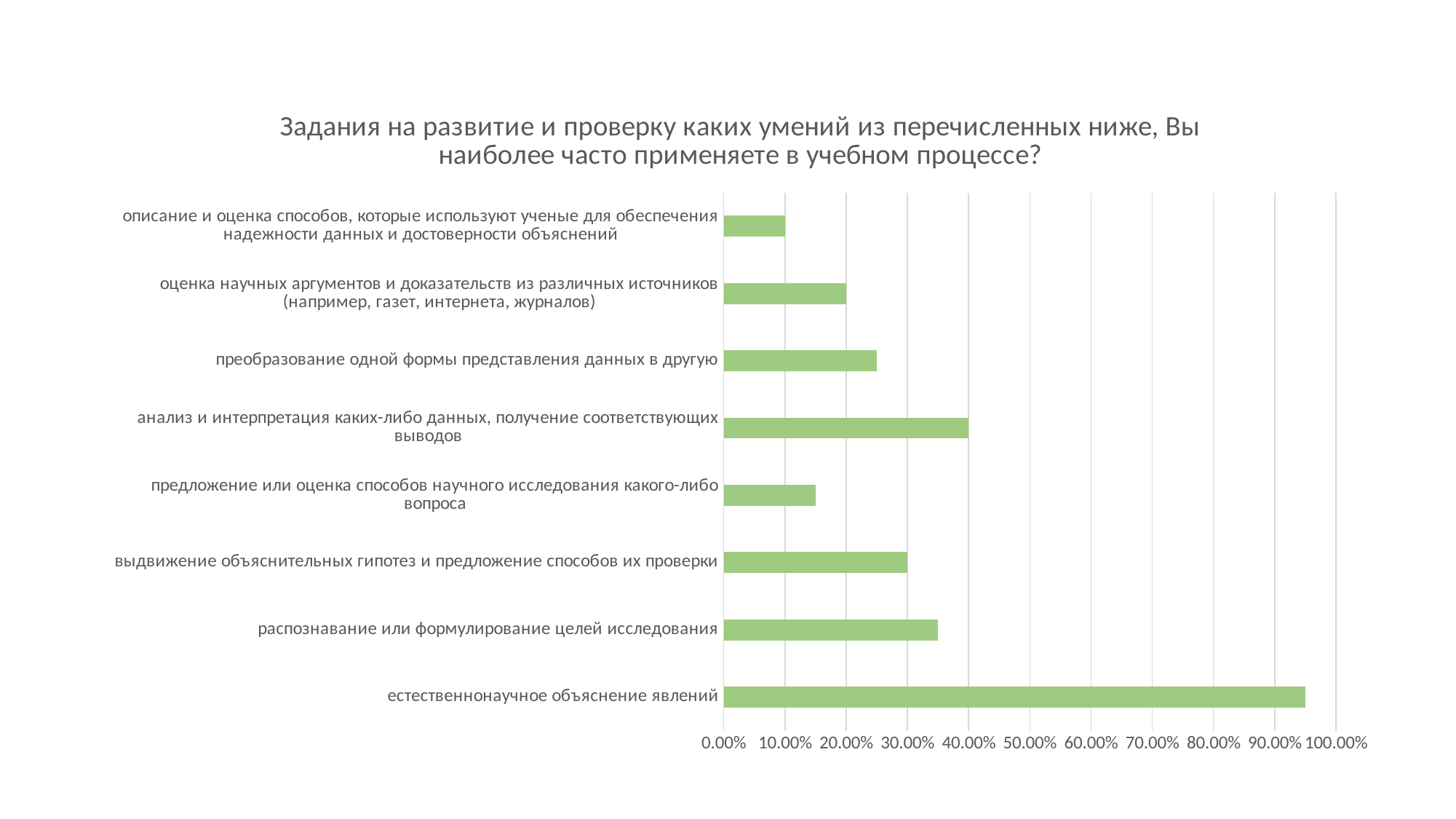
Is the value for 'распознавание или формулирование целей исследования' greater or less than 30.00%? greater Which category has the highest value in the chart? естественнонаучное объяснение явлений What kind of chart is shown on the slide? bar chart Is the value for 'предложение или оценка способов научного исследования какого-либо вопроса' greater or less than 20.00%? less What is the maximum value shown on the horizontal axis of the chart? 100.00% Is the value for 'естественнонаучное объяснение явлений' greater or less than 90.00%? greater Which is larger: the value for 'оценка научных аргументов и доказательств из различных источников (например, газет, интернета, журналов)' or the value for 'преобразование одной формы представления данных в другую'? преобразование одной формы представления данных в другую How many categories (skills) are plotted in the chart? 8 Which is larger: the value for 'анализ и интерпретация каких-либо данных, получение соответствующих выводов' or the value for 'выдвижение объяснительных гипотез и предложение способов их проверки'? анализ и интерпретация каких-либо данных, получение соответствующих выводов What is the title of the chart? Задания на развитие и проверку каких умений из перечисленных ниже, Вы наиболее часто применяете в учебном процессе? Which category has the lowest value in the chart? описание и оценка способов, которые используют ученые для обеспечения надежности данных и достоверности объяснений